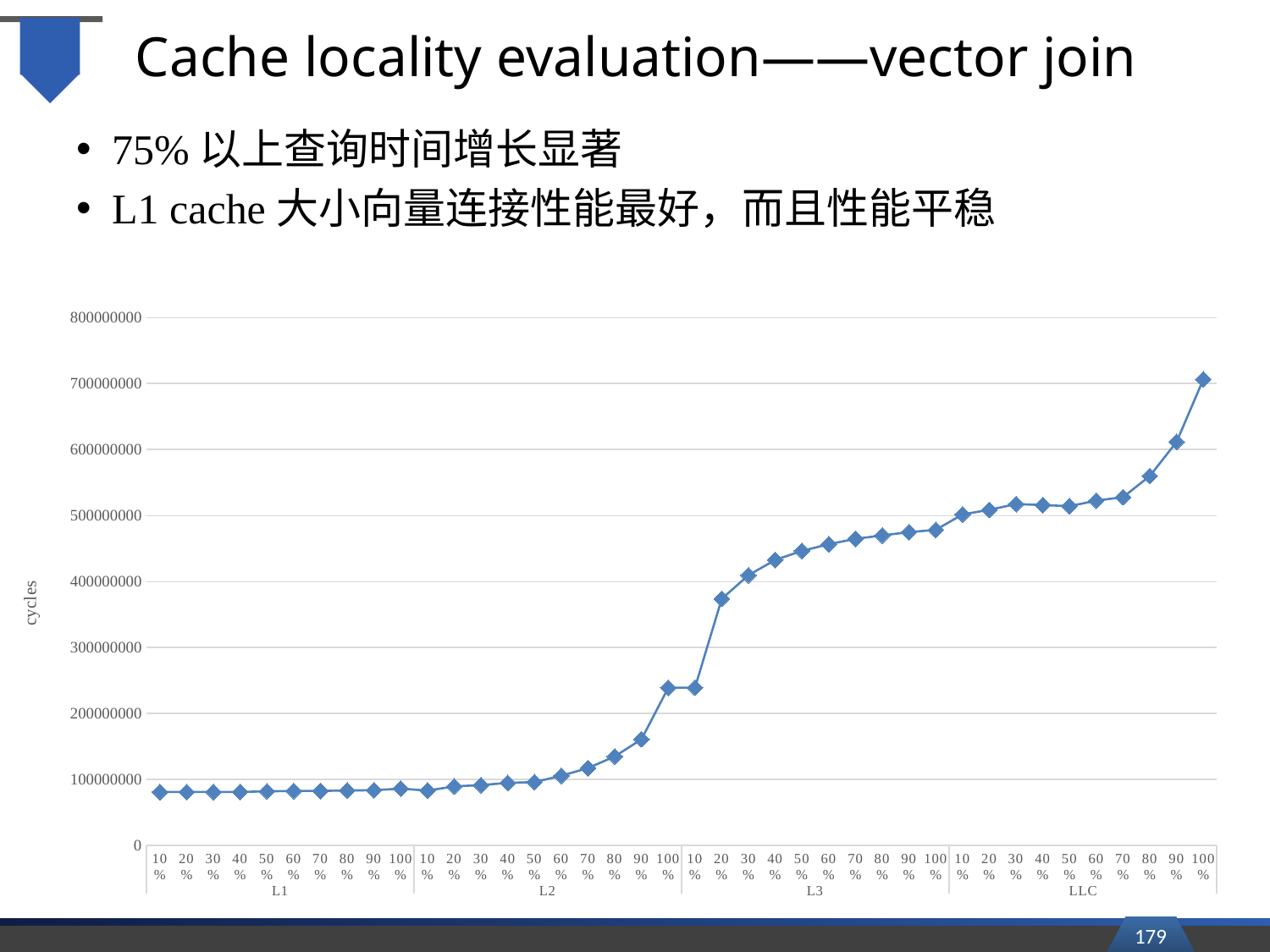
Is the value for L2 90% greater or less than 200000000? less Is the value for L3 10% greater or less than 400000000? less Is the value for LLC 100% greater or less than 600000000? greater Which cache-level group has the lowest values in the chart? L1 How many cache-level groups are shown along the x axis of the chart? 4 What is the label on the y axis of the chart? cycles Do the values generally rise or fall from left to right along the x axis? rise Which x-axis point has the highest value in the chart? LLC 100% How many data points are plotted in the chart? 40 What kind of chart is shown on the slide? line chart